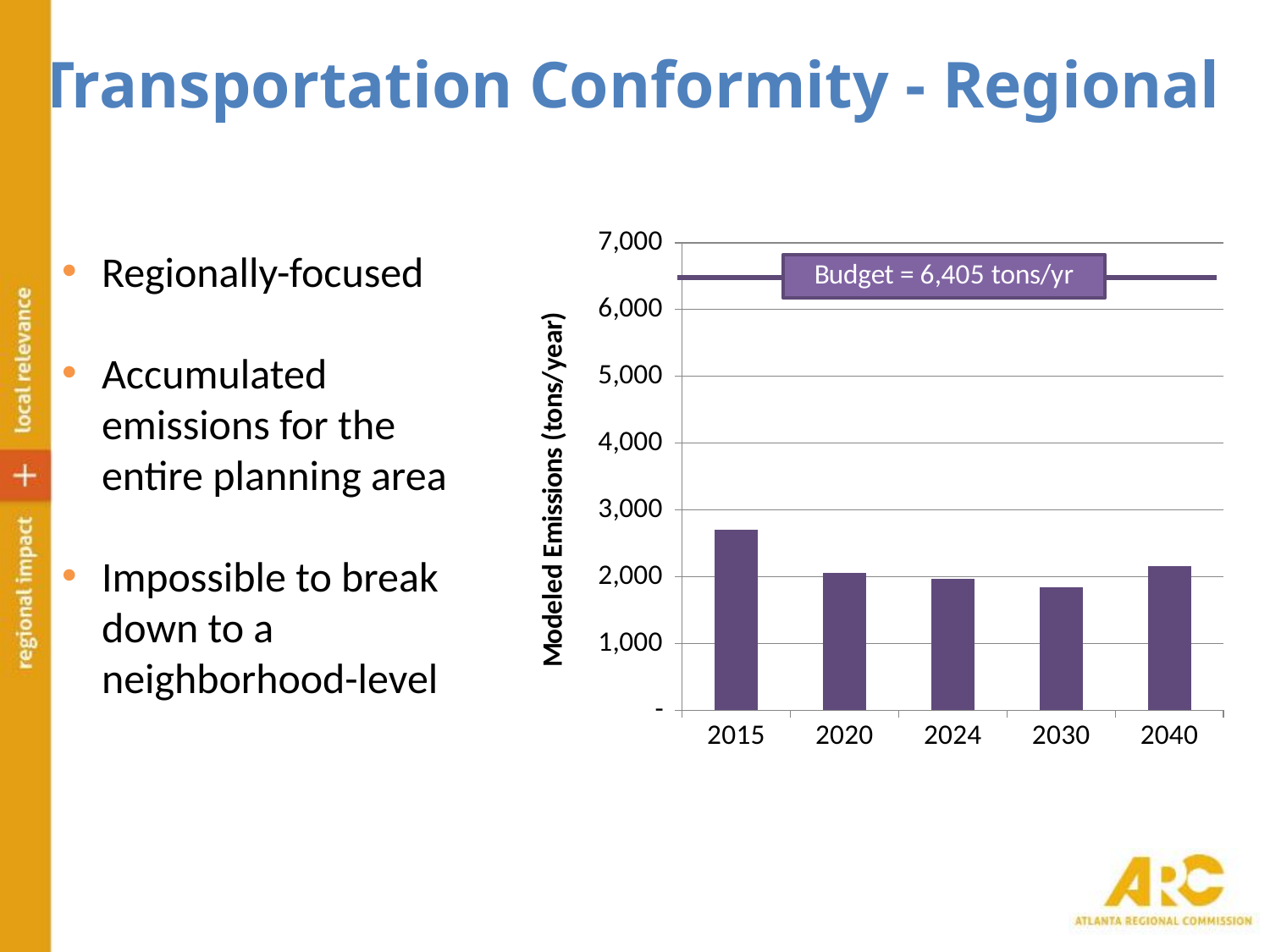
Is the modeled emissions value for 2015 greater or less than 3,000? less Which year has the lowest modeled emissions in the chart? 2030 Do the modeled emissions rise or fall from 2015 to 2030? fall Is the modeled emissions value for 2015 greater or less than 2,000? greater Which year has the highest modeled emissions in the chart? 2015 What is the label on the vertical axis of the chart? Modeled Emissions (tons/year) How many years are shown on the x axis of the chart? 5 Is the budget line on the chart above or below 6,000? above What kind of chart is shown on the slide? bar chart What is the budget value shown by the horizontal line on the chart? 6,405 tons/yr Which year has higher modeled emissions, 2015 or 2040? 2015